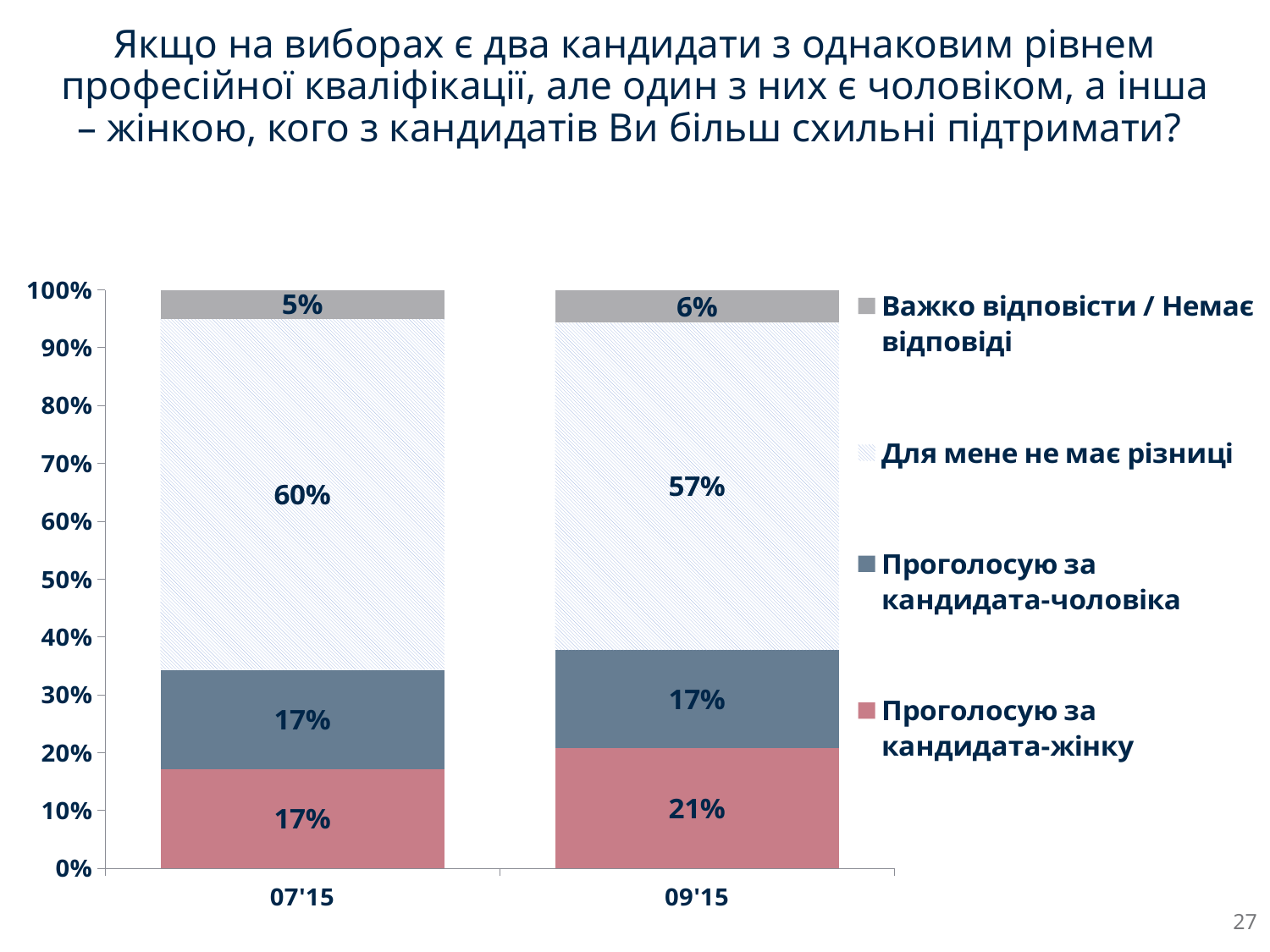
What kind of chart is shown on the slide? Stacked bar chart How many series does the legend list? 4 What is the value for 'Важко відповісти / Немає відповіді' in 09'15? 6% What percentage of respondents in 09'15 said they would vote for the female candidate (Проголосую за кандидата-жінку)? 21% What is the value for 'Для мене не має різниці' in 07'15? 60% What is the value for 'Проголосую за кандидата-чоловіка' in 07'15? 17% By how many percentage points did the share for 'Проголосую за кандидата-жінку' change from 07'15 to 09'15? 4% Which period has the higher share for 'Для мене не має різниці', 07'15 or 09'15? 07'15 What is the difference between 'Для мене не має різниці' in 07'15 and in 09'15? 3% How many time periods are shown on the x axis? 2 Which series has the largest share in the 09'15 bar? Для мене не має різниці Which series has the smallest share in the 07'15 bar? Важко відповісти / Немає відповіді